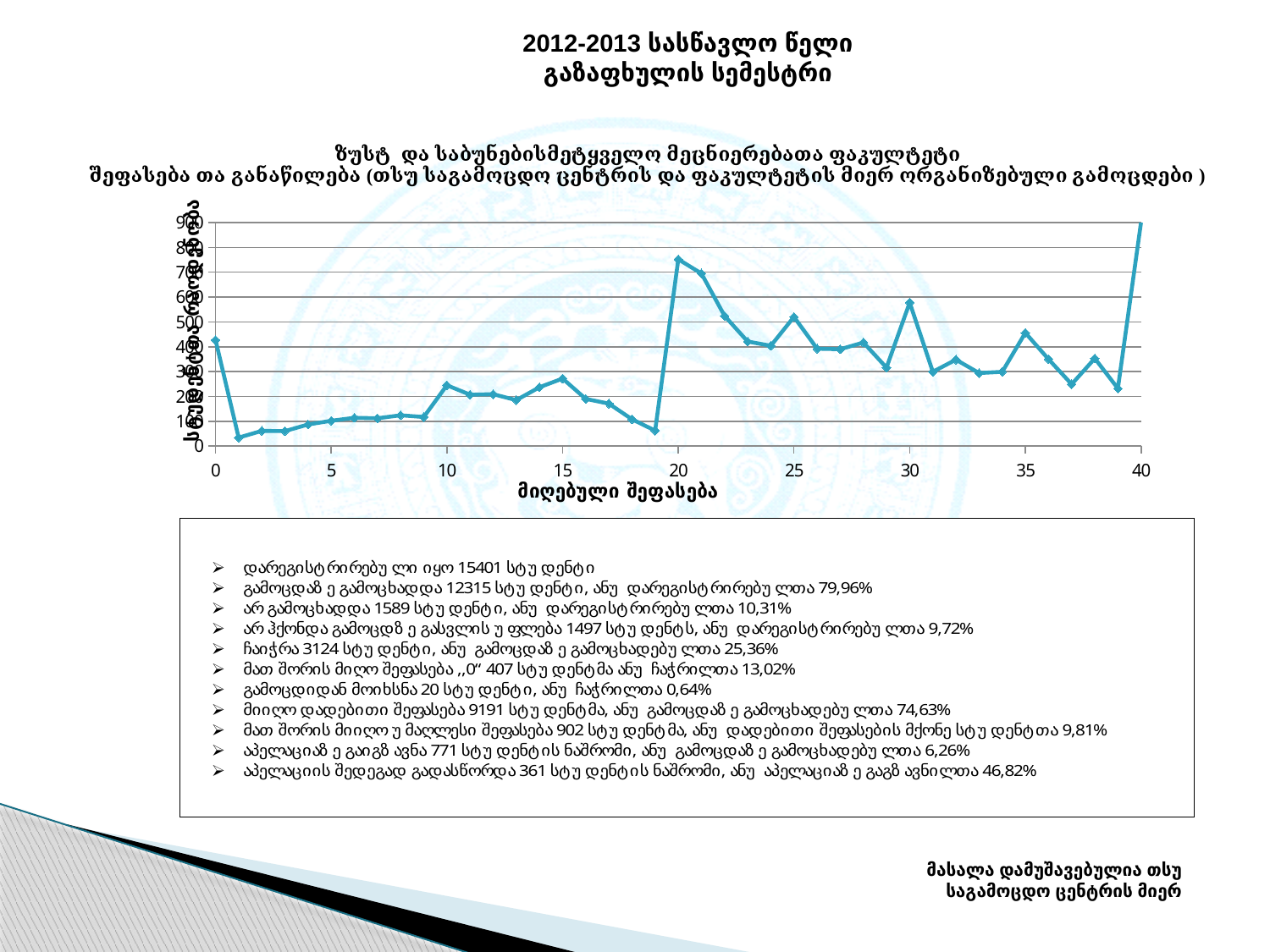
Is the value at x = 30 greater or less than 500? greater Is the value at x = 0 greater or less than 300? greater What is the highest tick value shown on the x axis of the chart? 40 What kind of chart is shown on the slide? line chart Is the value at x = 40 greater or less than 800? greater Does the line rise or fall between x = 20 and x = 22? fall At which x value does the line reach its highest point? 40 What is the label of the x axis of the chart? მიღებული შეფასება Which has the larger value, x = 19 or x = 20? x = 20